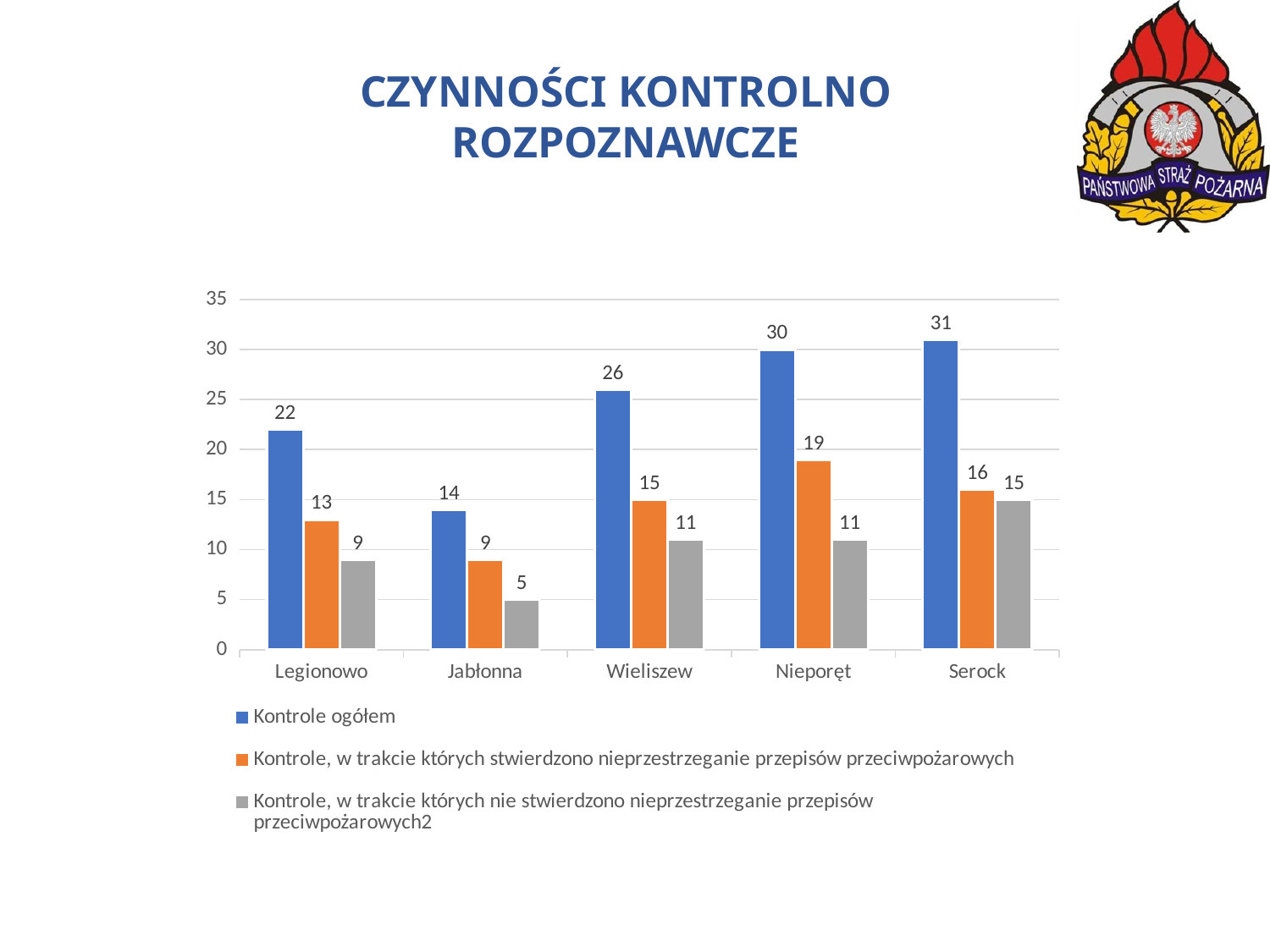
What is the value of the grey series (Kontrole, w trakcie których nie stwierdzono nieprzestrzeganie przepisów przeciwpożarowych2) for Jabłonna? 5 How many categories are shown on the x axis? 5 Is the value of Kontrole ogółem for Wieliszew greater or less than 25? greater What is the title of the slide? CZYNNOŚCI KONTROLNO ROZPOZNAWCZE What is the difference between Kontrole ogółem for Nieporęt and for Legionowo? 8 What kind of chart is shown on the slide? bar chart What is the value of Kontrole ogółem for Serock? 31 Which is larger: the orange series value for Wieliszew or for Serock? Serock How many series does the legend list? 3 Which category has the highest value for Kontrole ogółem? Serock Which category has the lowest value for Kontrole ogółem? Jabłonna What is the value of Kontrole, w trakcie których stwierdzono nieprzestrzeganie przepisów przeciwpożarowych for Nieporęt? 19